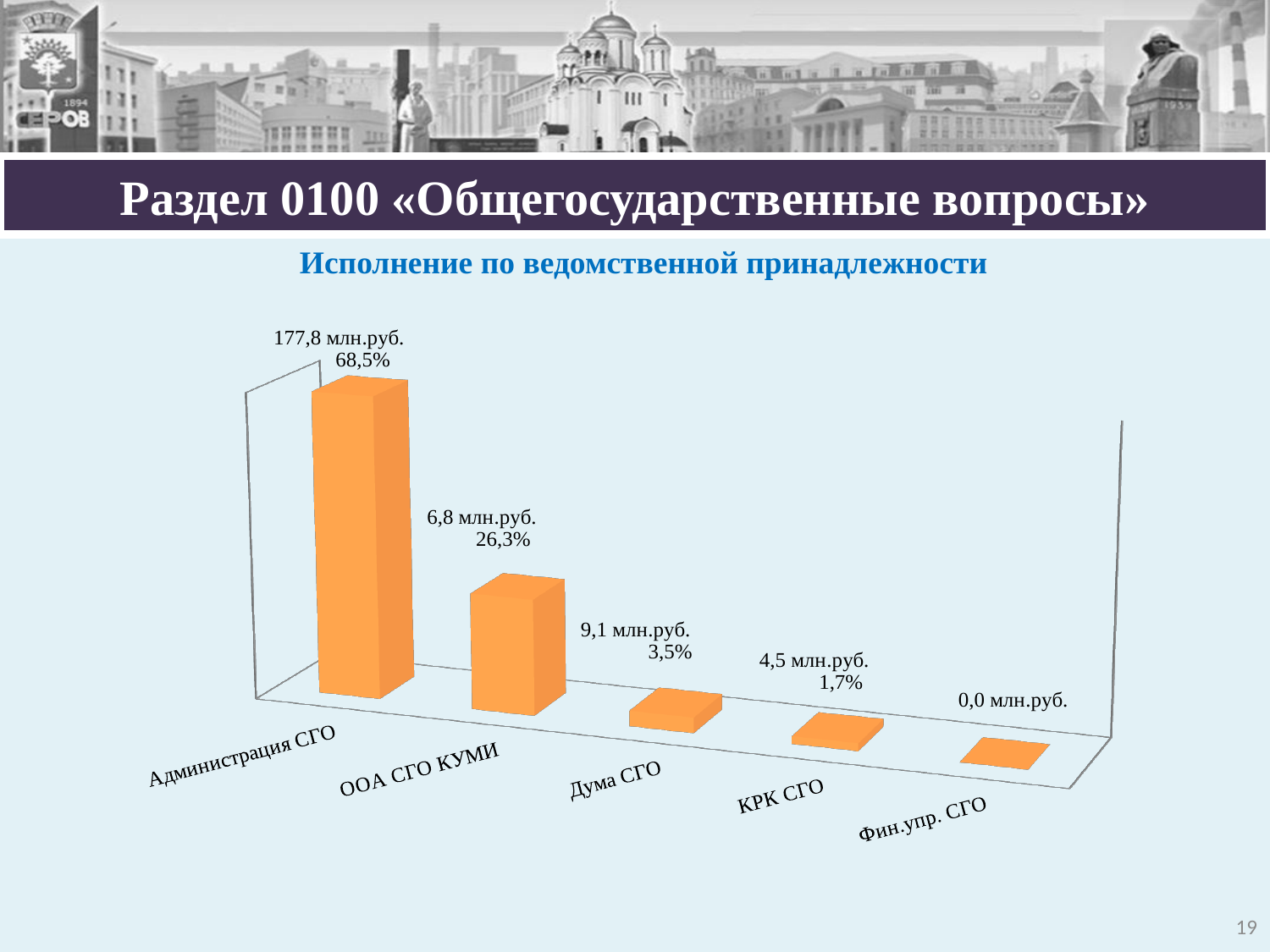
Which is larger, the value for Администрация СГО or the value for КРК СГО? Администрация СГО What is the difference in млн.руб. between Администрация СГО and КРК СГО? 173,3 млн.руб. What value is shown for ООА СГО КУМИ? 6,8 млн.руб. Which category has the lowest value? Фин.упр. СГО What value is shown for КРК СГО? 4,5 млн.руб. What value is shown for Фин.упр. СГО? 0,0 млн.руб. What percentage is shown for Дума СГО? 3,5% Which category has the highest value? Администрация СГО What percentage is shown for Администрация СГО? 68,5% How many categories are shown in the chart? 5 What value is shown for Администрация СГО? 177,8 млн.руб. What kind of chart is shown on the slide? Bar chart